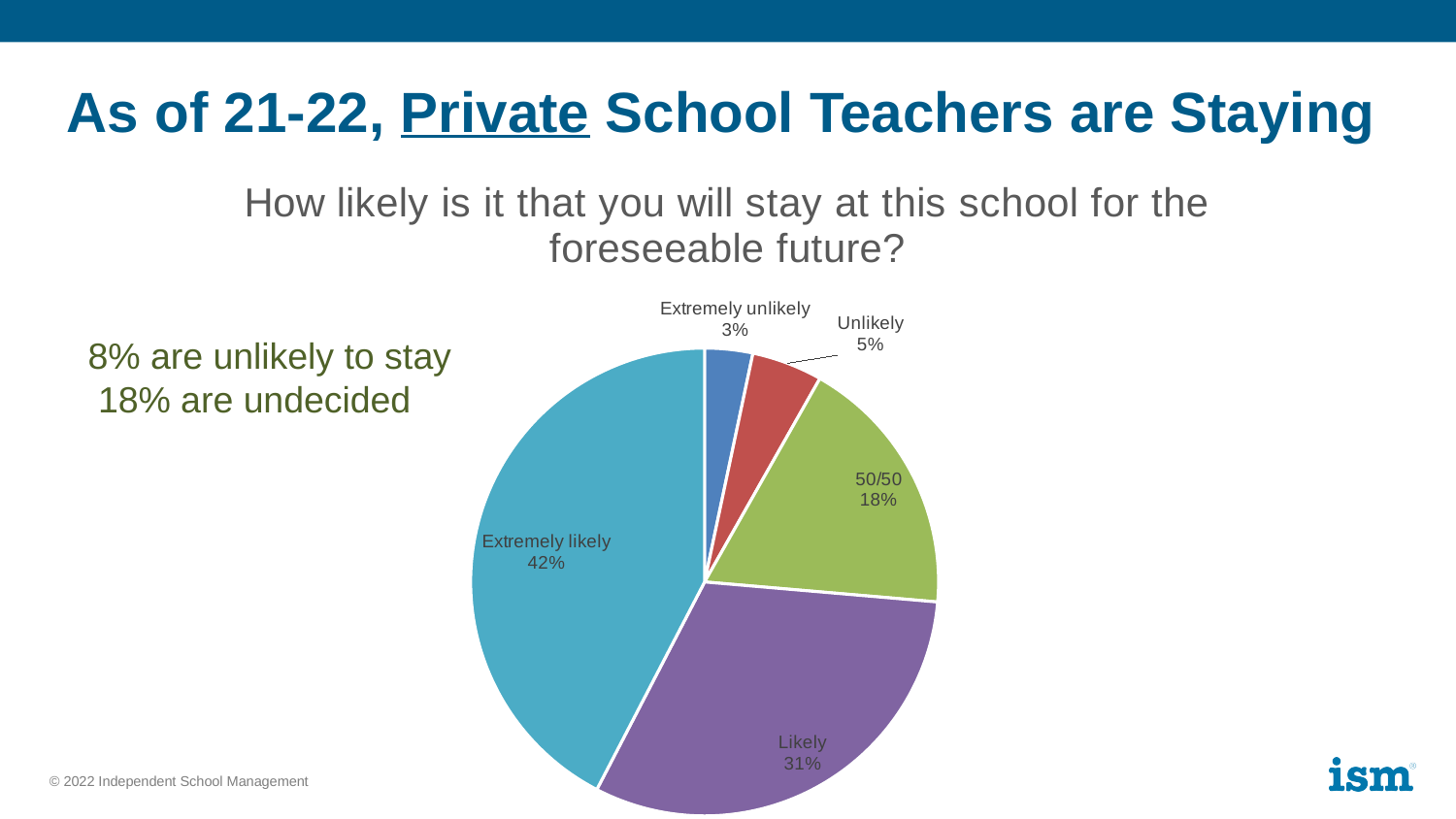
What is the combined share of "Extremely likely" and "Likely"? 73% What percentage of respondents answered "Unlikely"? 5% What kind of chart is shown on the slide? Pie chart What percentage of respondents answered "50/50"? 18% Which is larger, the share for "50/50" or the share for "Unlikely"? 50/50 What is the difference in percentage points between "Extremely likely" and "Likely"? 11 Which response has the largest share of the pie? Extremely likely Which response has the smallest share of the pie? Extremely unlikely How many slices does the pie chart have? 5 What percentage of respondents answered "Extremely likely"? 42% What percentage of respondents answered "Extremely unlikely"? 3% What percentage of respondents answered "Likely"? 31%